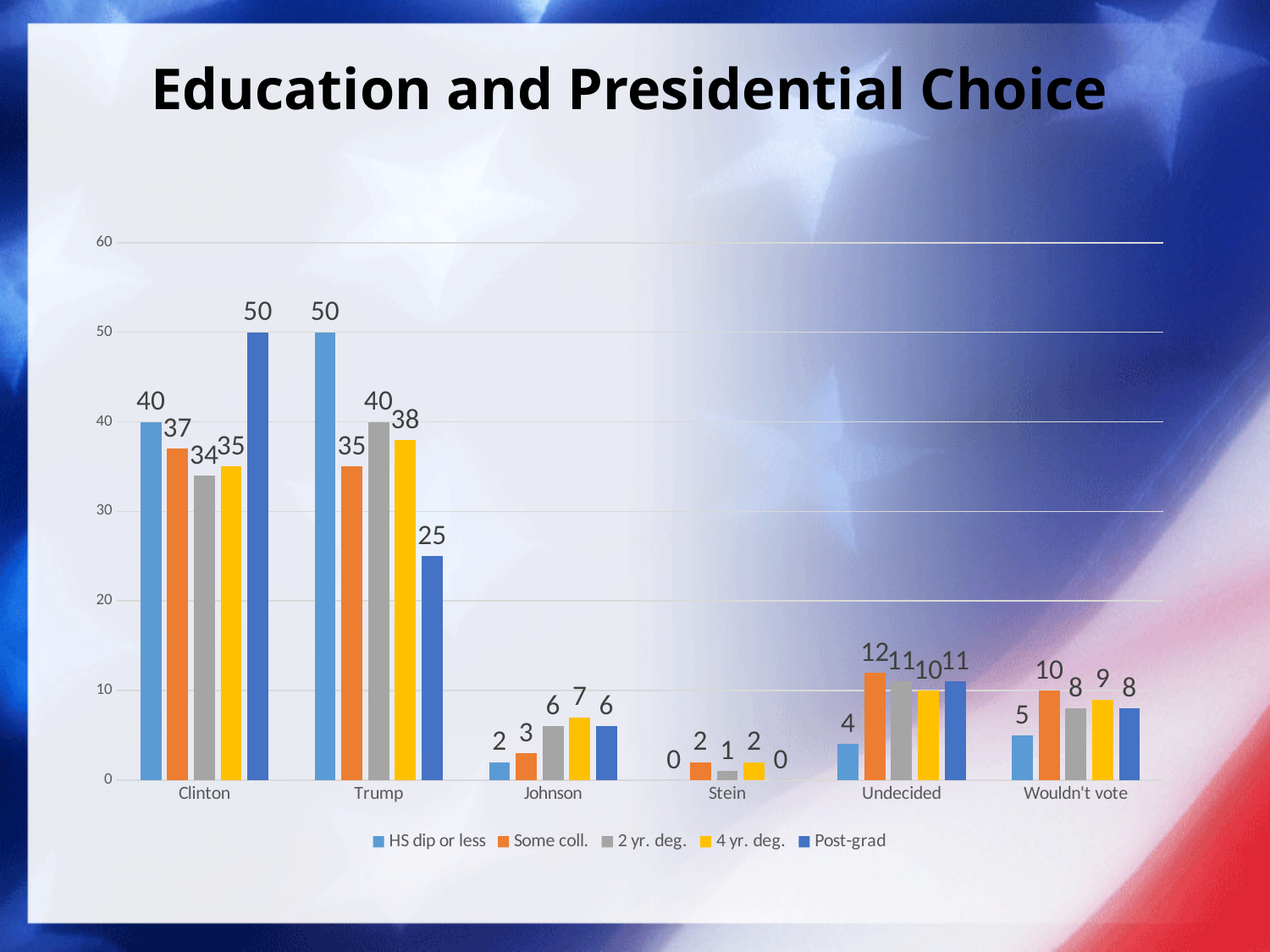
In the Clinton category, which is larger: the Some coll. value or the 2 yr. deg. value? Some coll. What is the title of the chart? Education and Presidential Choice What is the value for Post-grad in the Clinton category? 50 Which education group has the highest value in the Undecided category? Some coll. What is the value for HS dip or less in the Trump category? 50 What is the value for 2 yr. deg. in the Undecided category? 11 Which education group has the lowest value in the Trump category? Post-grad How many series does the legend list? 5 What is the difference between the HS dip or less value and the Post-grad value in the Trump category? 25 What kind of chart is shown on the slide? Bar chart How many candidate/response categories are shown on the x axis? 6 What is the value for Some coll. in the Wouldn't vote category? 10